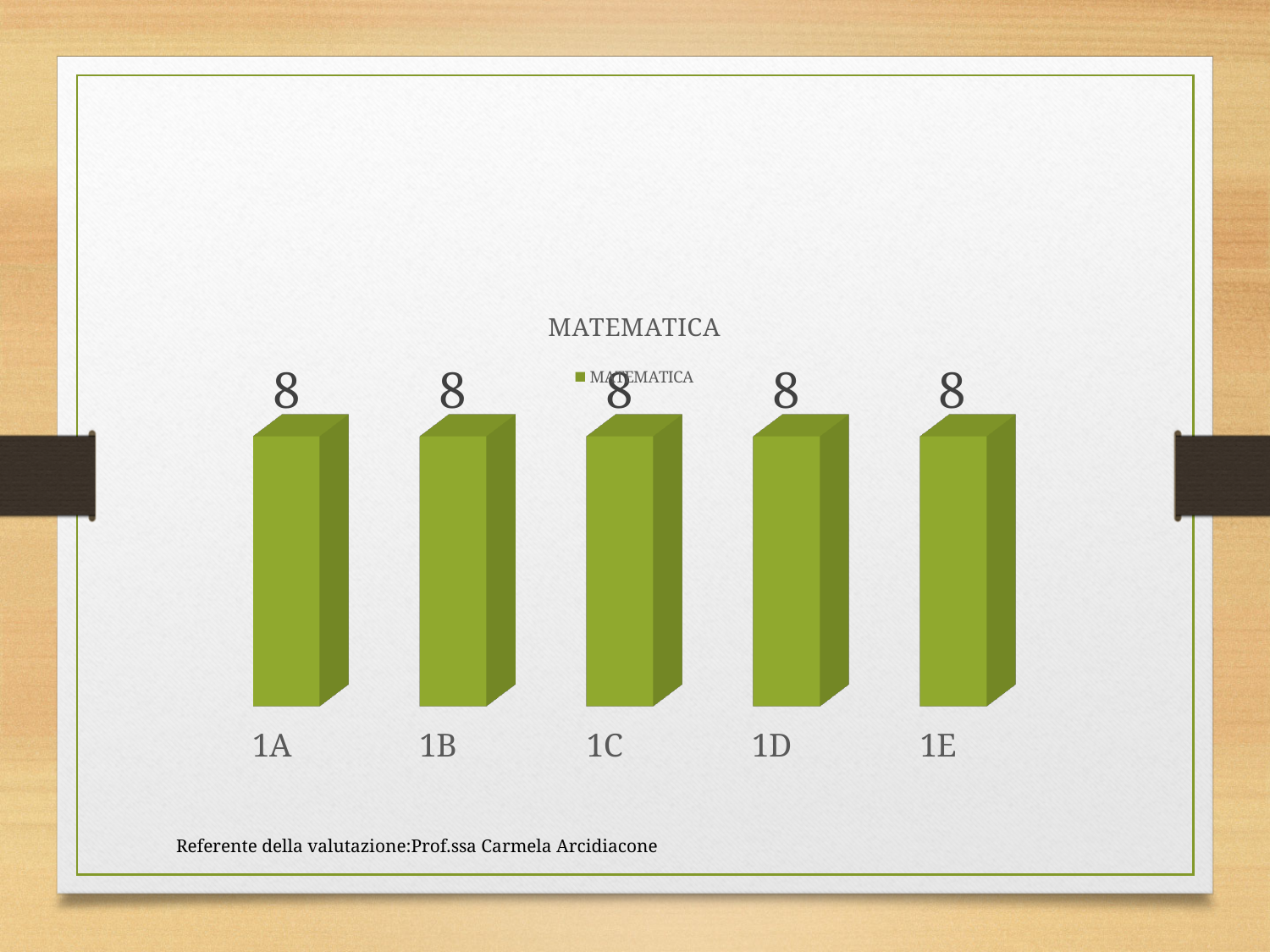
What is the value for 1A in the MATEMATICA chart? 8 What is the value for 1E in the MATEMATICA chart? 8 What is the total of the values for all five categories? 40 How many series does the legend list? 1 What is the title of the chart? MATEMATICA How many categories are shown on the x axis of the chart? 5 What is the name of the series listed in the legend? MATEMATICA Do the values rise, fall or stay the same from 1A to 1E? stay the same What is the difference between the values for 1B and 1D? 0 What kind of chart is shown on the slide? bar chart What is the value for 1C in the MATEMATICA chart? 8